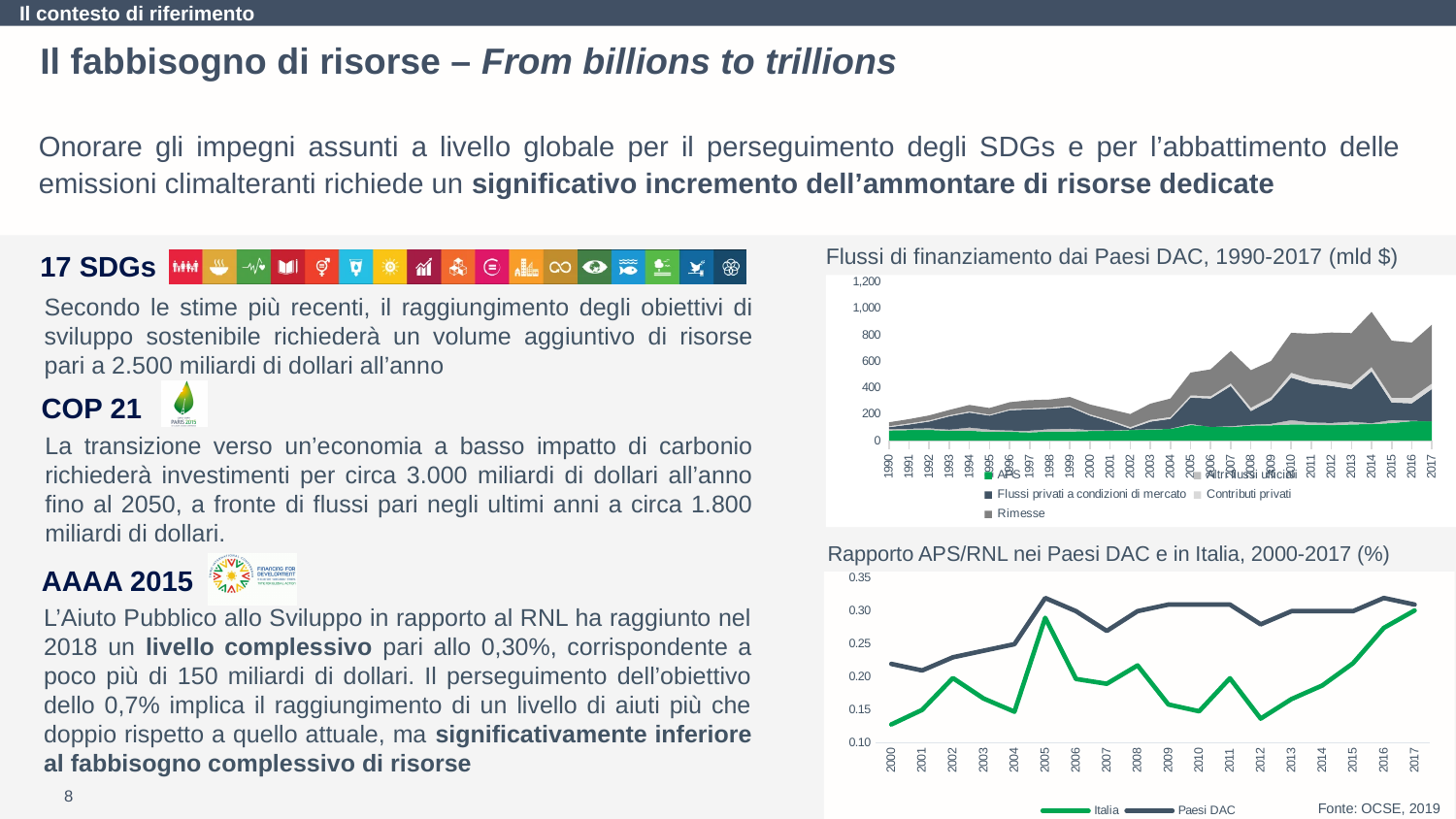
What kind of chart is the 'Flussi di finanziamento dai Paesi DAC, 1990-2017 (mld $)' chart? Stacked area chart What source is cited for the charts on the slide? OCSE, 2019 How many series does the legend of the 'Flussi di finanziamento dai Paesi DAC' chart list? 5 In the 'Rapporto APS/RNL' chart, which series has the higher value in 2010, Italia or Paesi DAC? Paesi DAC What kind of chart is the 'Rapporto APS/RNL nei Paesi DAC e in Italia, 2000-2017 (%)' chart? Line chart In the 'Rapporto APS/RNL' chart, does the Italia line rise or fall from 2012 to 2017? Rises In the 'Rapporto APS/RNL' chart, is the value for Italia in 2012 greater or less than 0.15? less How many years are shown on the x axis of the 'Rapporto APS/RNL nei Paesi DAC e in Italia, 2000-2017' chart? 18 How many series does the legend of the 'Rapporto APS/RNL nei Paesi DAC e in Italia' chart list? 2 In the 'Rapporto APS/RNL' chart, is the value for Paesi DAC in 2005 greater or less than 0.30? greater In the 'Flussi di finanziamento dai Paesi DAC' chart, is the total stacked value in 1990 greater or less than 200? less